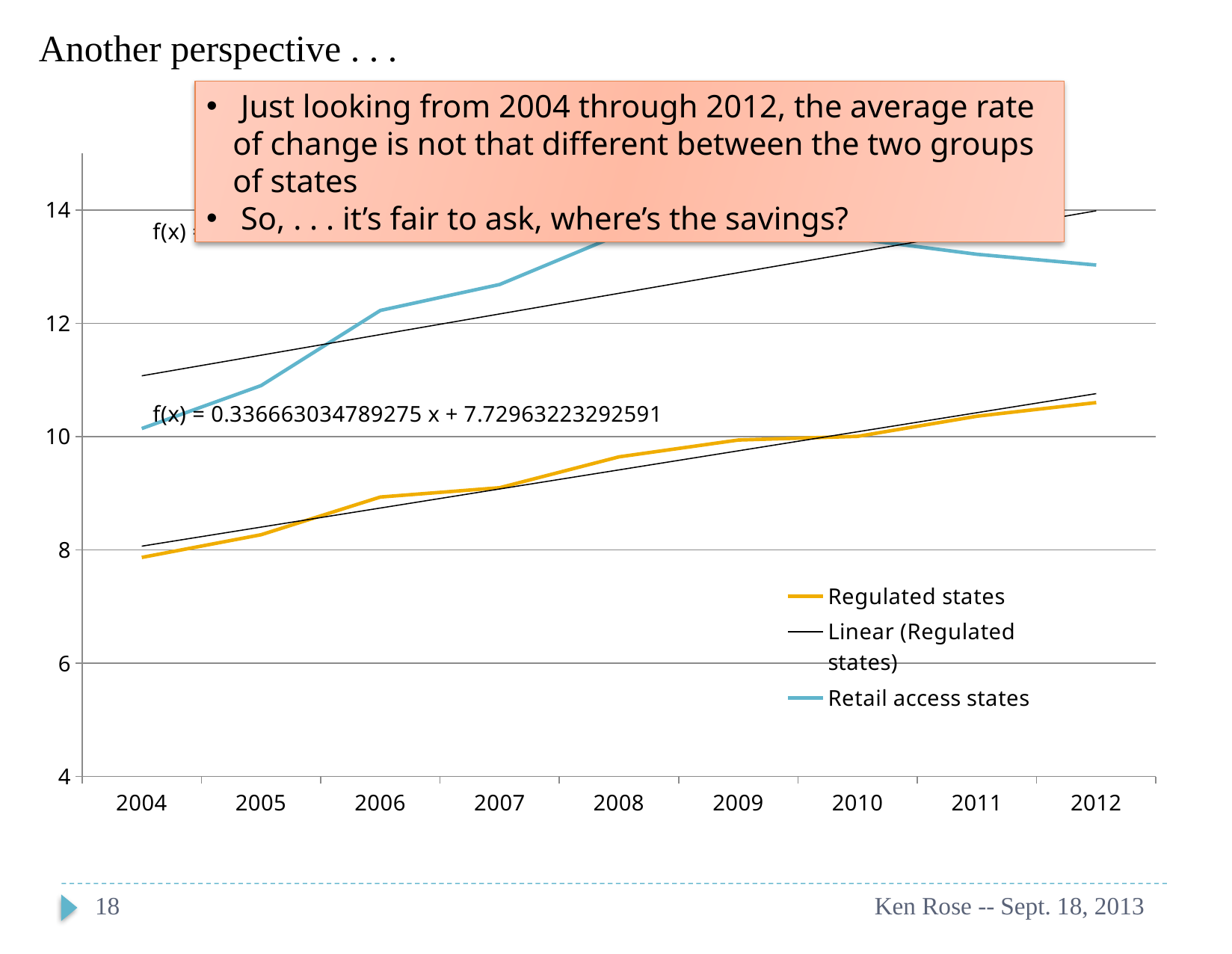
Is the value for Retail access states in 2012 greater or less than 12? greater What is the trendline equation printed for the Regulated states series? f(x) = 0.336663034789275 x + 7.72963223292591 Is the value for Regulated states in 2007 greater or less than 8? greater How many entries does the chart's legend list? 3 What colour is the Retail access states line in the chart? blue Does the Regulated states line rise or fall from 2004 to 2012? rises Which year has the highest value for Regulated states? 2012 How many years are shown on the x axis of the chart? 9 Is the value for Regulated states in 2012 greater or less than 10? greater Which year has the lowest value for Retail access states? 2004 In 2008, which series has the higher value, Regulated states or Retail access states? Retail access states What kind of chart is shown on the slide? line chart